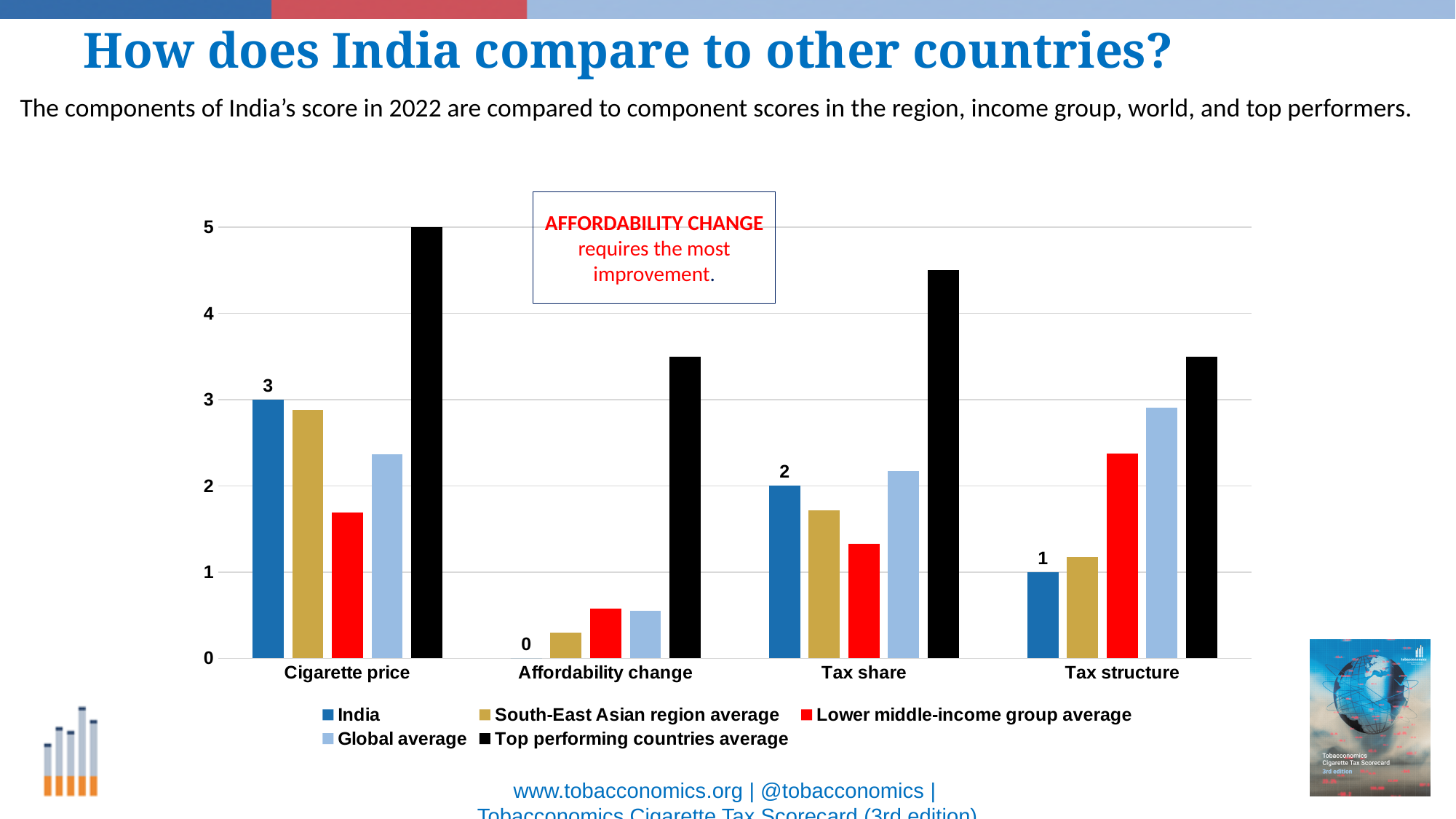
Which component has India's highest score? Cigarette price What kind of chart is shown on the slide? Bar chart Is the Top performing countries average for Tax share greater or less than 4? greater Which component has India's lowest score? Affordability change What is the Top performing countries average score for Cigarette price? 5 How many series does the legend list? 5 What is the difference between India's Cigarette price score and its Tax structure score? 2 What is India's score for Tax structure? 1 For Tax structure, which is larger: India or the Lower middle-income group average? Lower middle-income group average What is India's score for Affordability change? 0 What is India's score for Cigarette price? 3 What is India's score for Tax share? 2